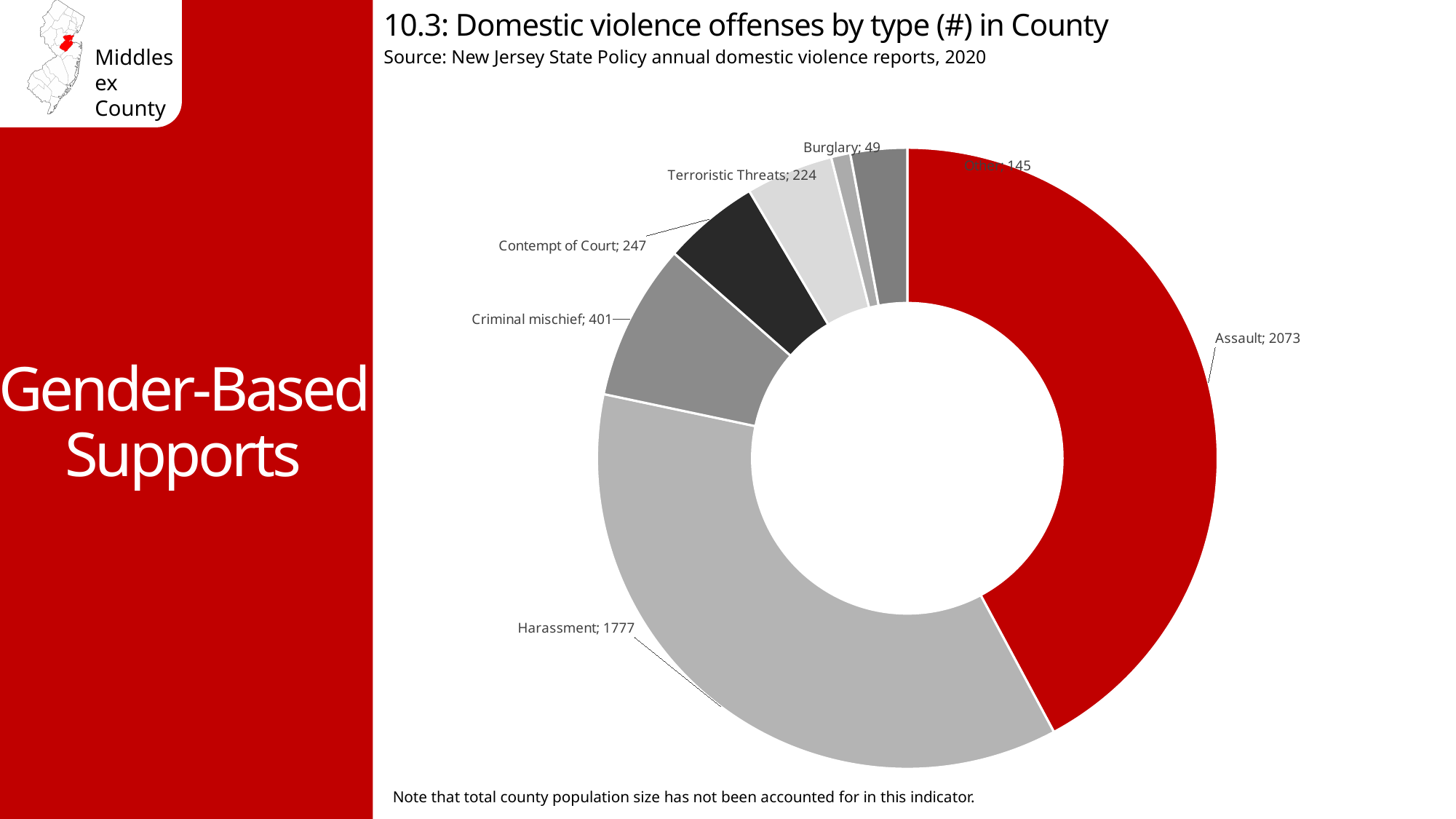
What is the value for Burglary? 49 What is the value for Terroristic Threats? 224 Which offense type has the highest number of offenses? Assault What is the value for Contempt of Court? 247 How many domestic violence offenses of type Assault are shown on the chart? 2073 What kind of chart is shown on the slide? doughnut chart Which is larger, Criminal mischief or Contempt of Court? Criminal mischief What is the value for Harassment on the chart? 1777 What is the difference between the Assault and Harassment values? 296 What is the source cited for the chart? New Jersey State Policy annual domestic violence reports, 2020 What is the value for Criminal mischief? 401 Which labeled offense type has the lowest number of offenses? Burglary